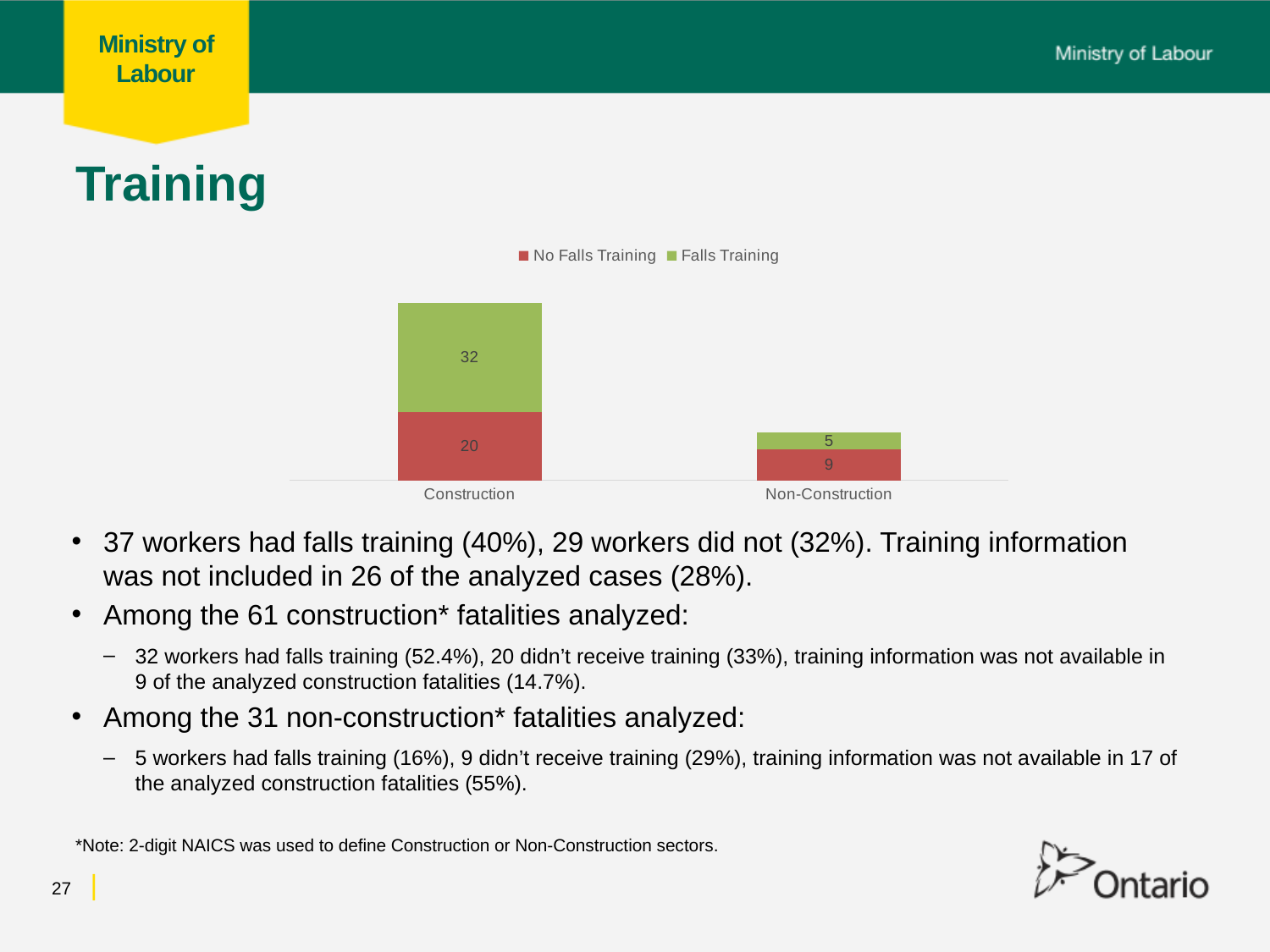
Which category has the lowest Falls Training value? Non-Construction How many series does the legend list? 2 What is the total of the stacked bar for Construction? 52 What is the difference between the Falls Training values for Construction and Non-Construction? 27 What kind of chart is shown on the slide? Stacked bar chart What is the value for No Falls Training in the Construction category? 20 Which category has the higher No Falls Training value, Construction or Non-Construction? Construction What is the value for Falls Training in the Construction category? 32 What is the value for Falls Training in the Non-Construction category? 5 What is the total of the stacked bar for Non-Construction? 14 How many categories are shown on the x axis? 2 What is the value for No Falls Training in the Non-Construction category? 9